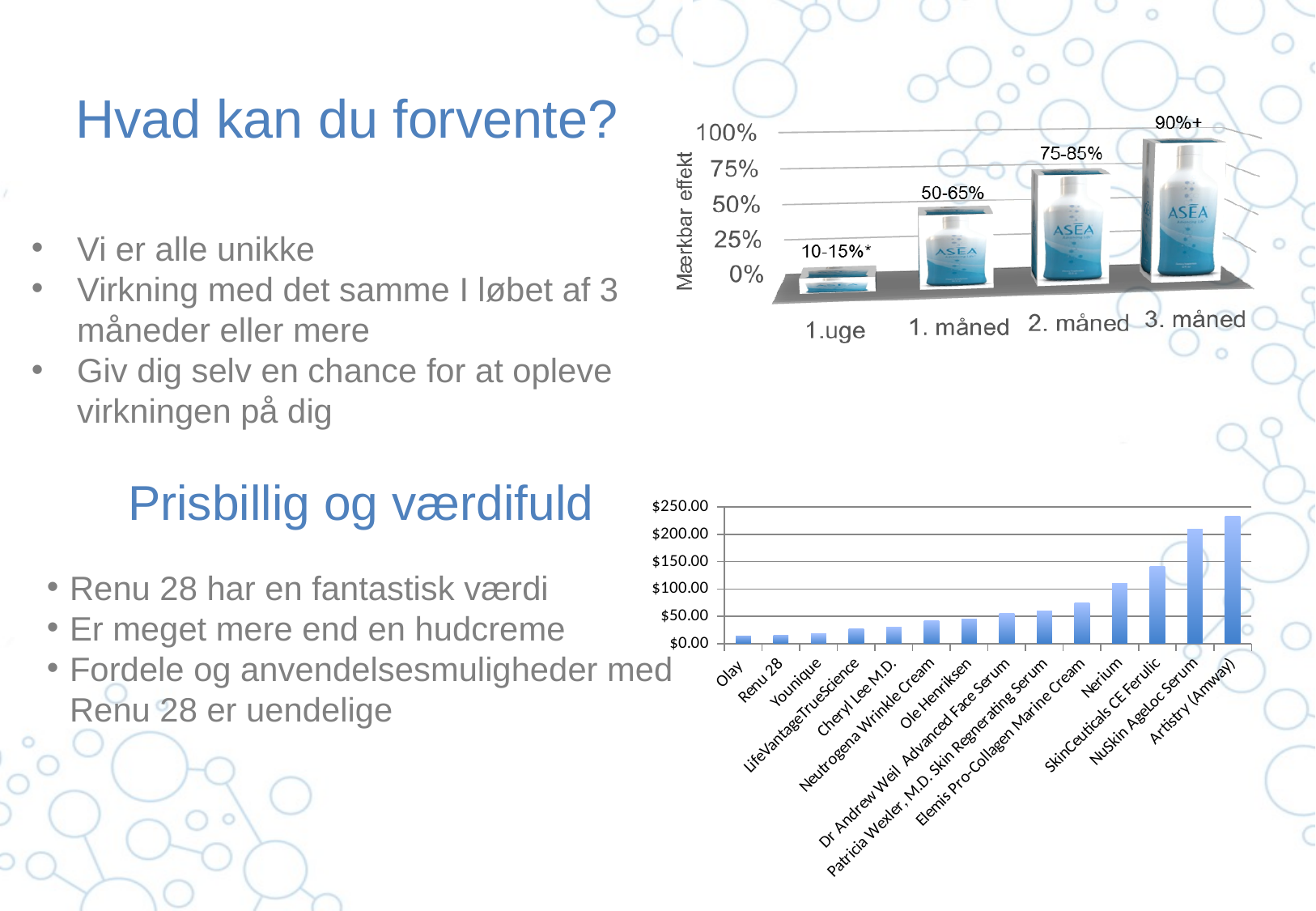
In the top chart (Mærkbar effekt), what is the value labelled for 3. måned? 90%+ In the top chart (Mærkbar effekt), do the values rise or fall from 1.uge to 3. måned? rise In the bottom price chart, which product has the highest price? Artistry (Amway) In the top chart (Mærkbar effekt), what is the value labelled for 1. måned? 50-65% In the top chart (Mærkbar effekt), what is the value labelled for 1.uge? 10-15%* In the bottom price chart, which is higher, SkinCeuticals CE Ferulic or Renu 28? SkinCeuticals CE Ferulic In the top chart (Mærkbar effekt), how many time periods are shown on the x axis? 4 In the top chart, what is the label on the vertical axis? Mærkbar effekt In the bottom price chart, is the value for Nerium greater or less than $100.00? greater In the bottom price chart, what kind of chart is it? bar chart In the bottom price chart, is the value for Olay greater or less than $50.00? less In the bottom price chart, how many products are shown? 14